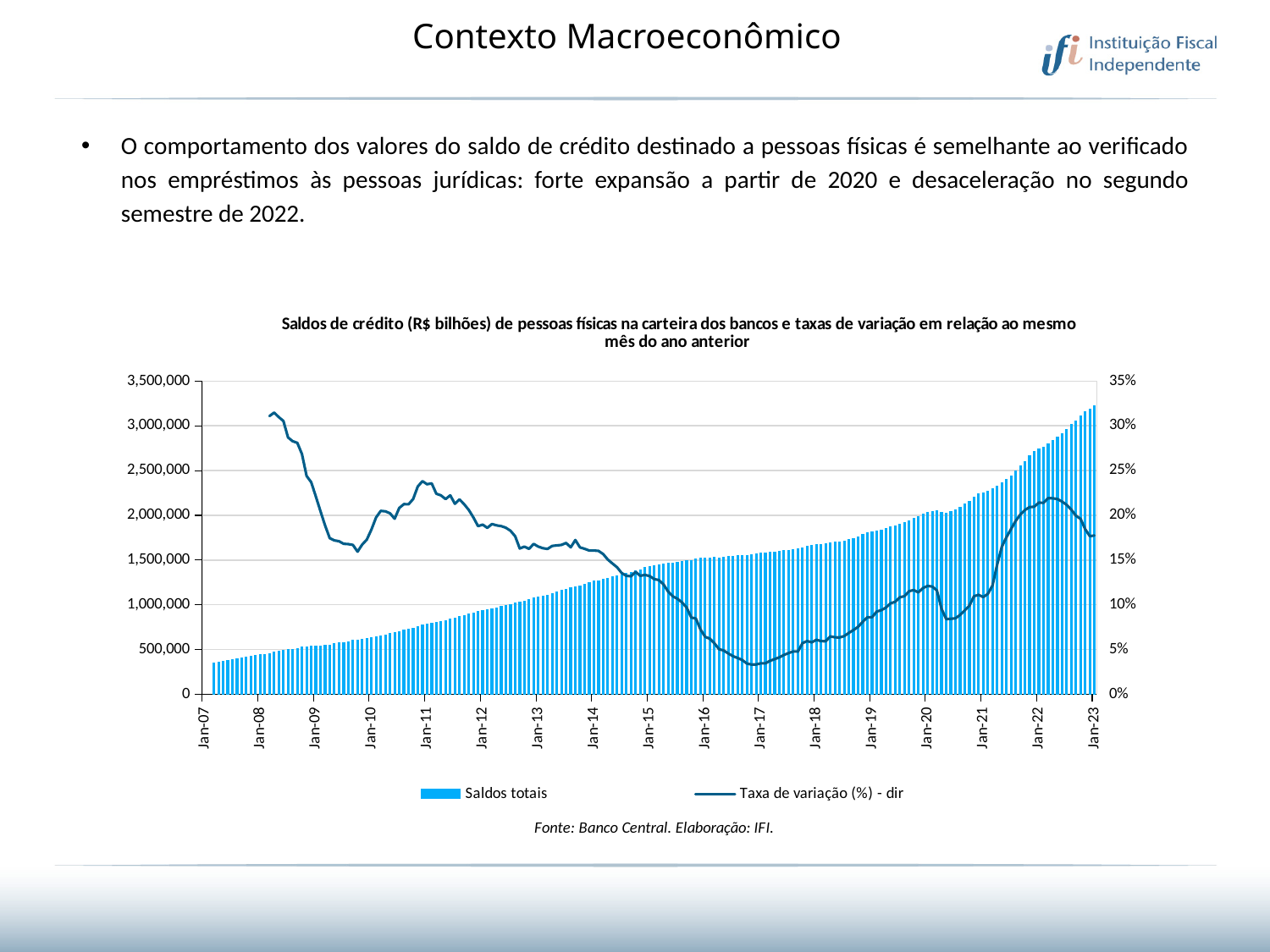
At which x-axis label do the Saldos totais bars reach their highest value? Jan-23 What is the source cited below the chart? Banco Central. Elaboração: IFI. Is the Saldos totais value at Jan-07 greater or less than 500,000? less How many series does the chart legend list? 2 Which is larger for Taxa de variação (%): the value near Jan-08 or the value near Jan-17? Jan-08 Is the Taxa de variação (%) value around Jan-17 greater or less than 5%? less How many year labels are shown on the x axis? 17 Do the Saldos totais bars generally rise or fall from Jan-07 to Jan-23? Rise What are the two series named in the chart legend? Saldos totais; Taxa de variação (%) - dir At which x-axis label are the Saldos totais bars lowest? Jan-07 Is the Saldos totais value at Jan-23 greater or less than 3,000,000? greater What type of chart is shown on the slide? Combined bar and line chart